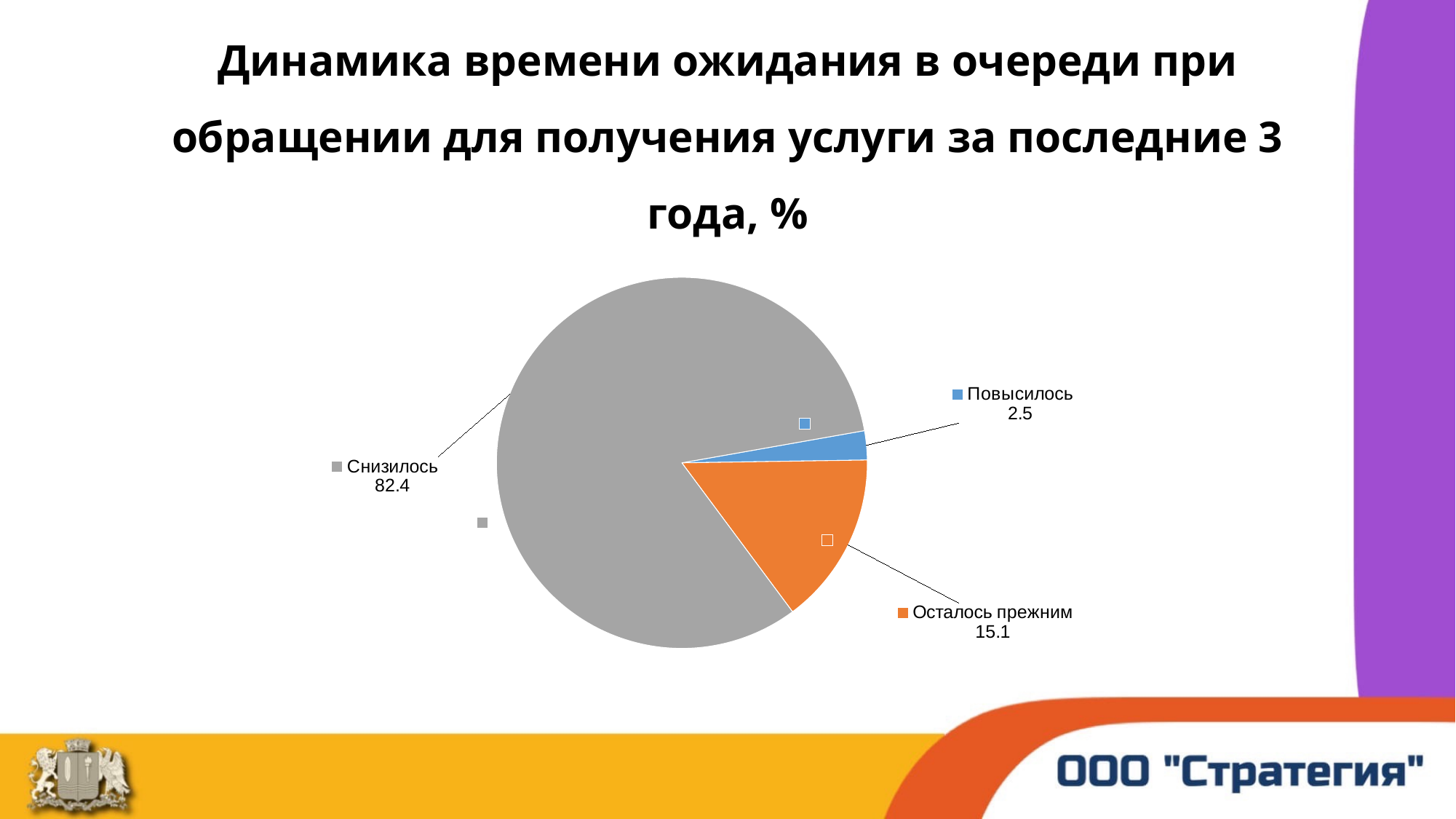
What type of chart is shown on the slide? pie chart Which category has the largest share of the pie? Снизилось How many slices does the pie chart have? 3 What is the value for "Осталось прежним"? 15.1 What colour is the slice for "Осталось прежним"? orange What colour is the slice for "Снизилось"? grey What is the value for "Повысилось"? 2.5 Which is larger, the value for "Осталось прежним" or the value for "Повысилось"? Осталось прежним Which category has the smallest share of the pie? Повысилось What is the difference between the values for "Снизилось" and "Осталось прежним"? 67.3 What is the value for "Снизилось"? 82.4 What is the difference between the values for "Осталось прежним" and "Повысилось"? 12.6